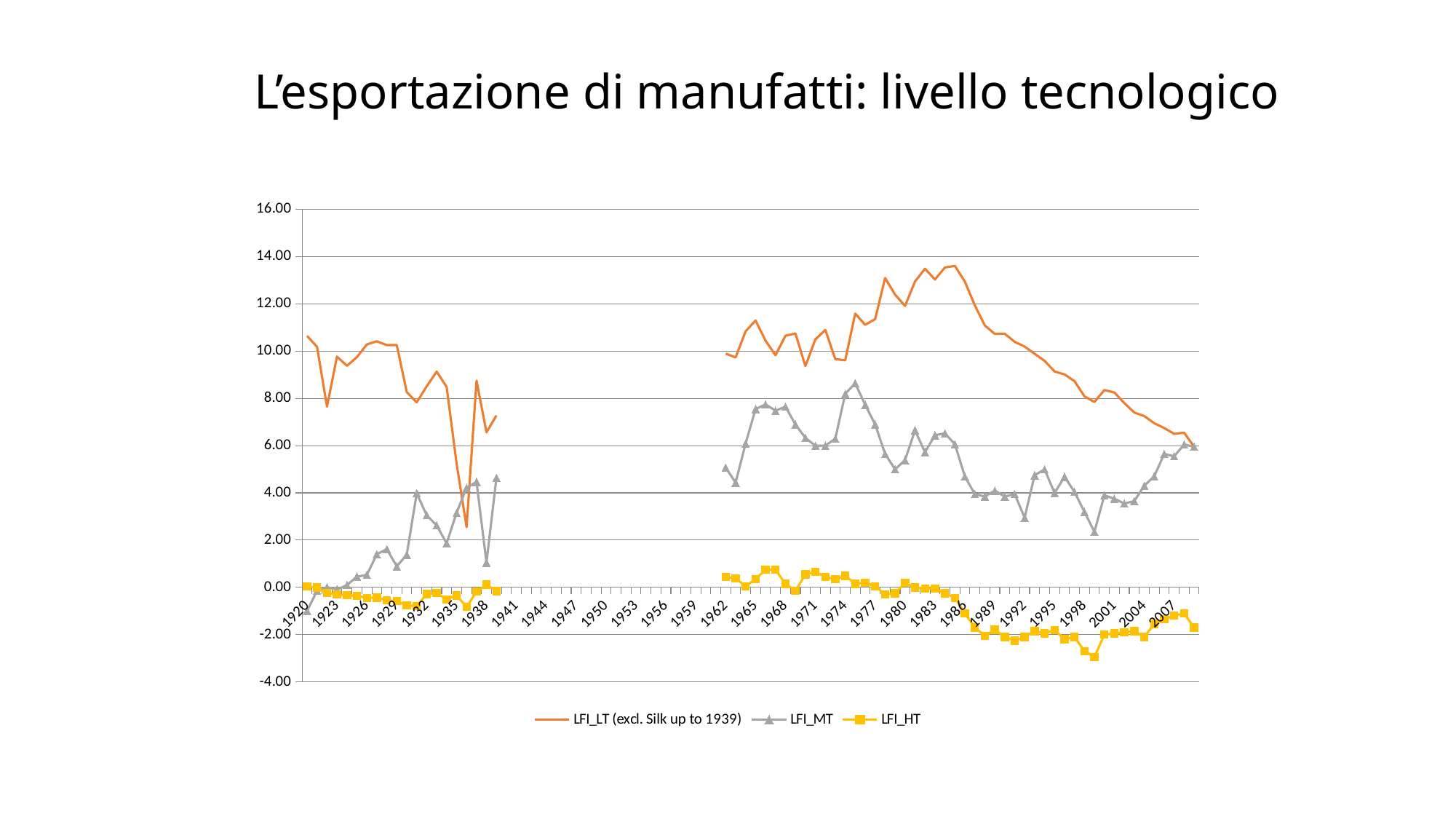
Is the value of LFI_MT in 1976 greater or less than 6.00? greater What is the title of the slide containing the chart? L'esportazione di manufatti: livello tecnologico In 1983, which series has the higher value, LFI_LT (excl. Silk up to 1939) or LFI_MT? LFI_LT (excl. Silk up to 1939) Does LFI_HT generally rise or fall from 1986 to 1999? fall What are the three series named in the legend? LFI_LT (excl. Silk up to 1939), LFI_MT, LFI_HT What kind of chart is shown on the slide? line chart How many series does the legend list? 3 Is the value of LFI_LT (excl. Silk up to 1939) in 1920 greater or less than 10.00? greater Does LFI_LT (excl. Silk up to 1939) generally rise or fall from 1986 to 2007? fall Is the lowest value of LFI_LT (excl. Silk up to 1939) in the 1930s greater or less than 4.00? less